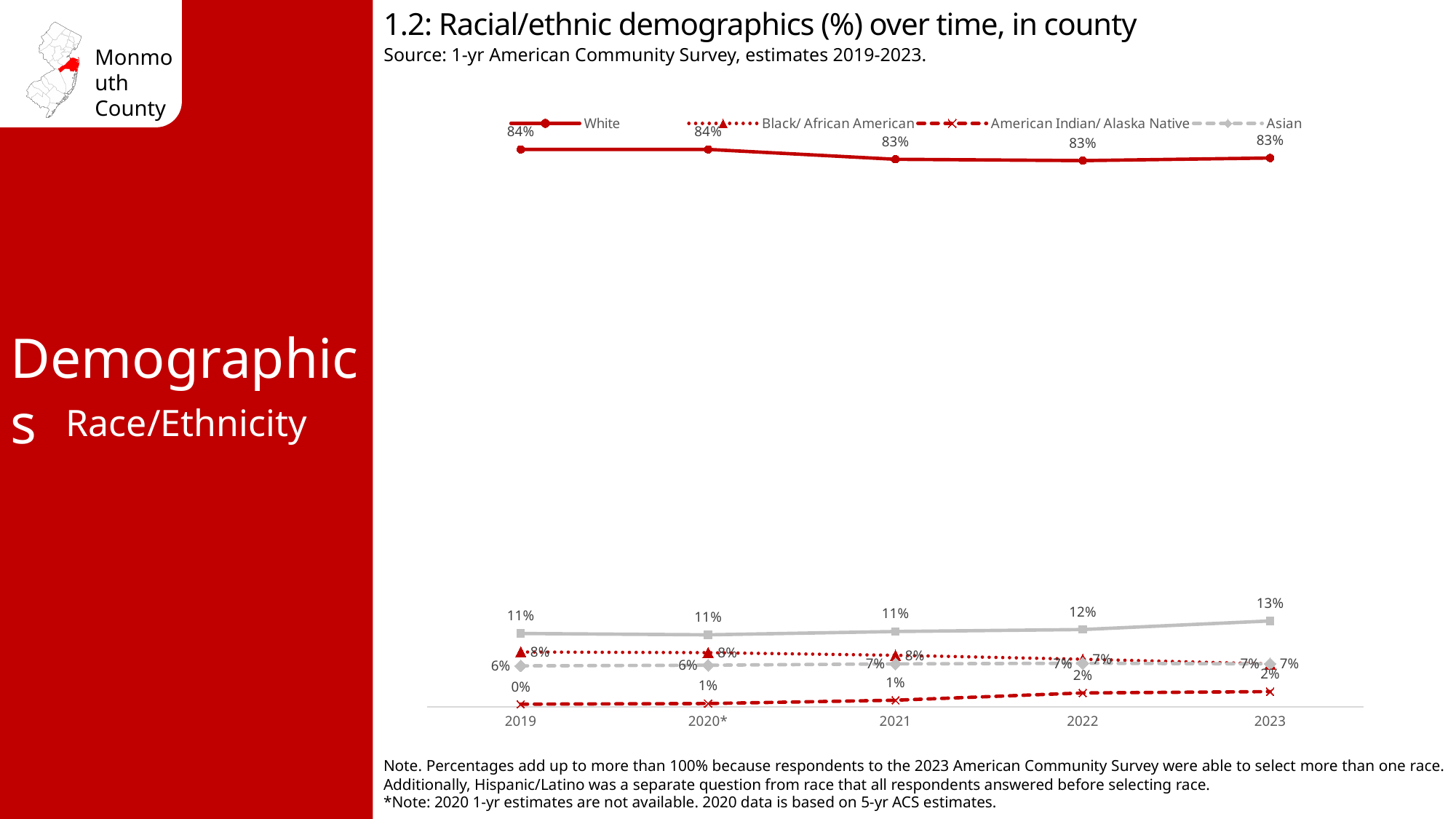
What percentage is shown for Asian in 2019? 6% Does the American Indian/ Alaska Native line rise or fall from 2019 to 2023? rise In 2019, which is larger: the Black/ African American value or the Asian value? Black/ African American What percentage is shown for White in 2023? 83% Which year on the x axis is marked with an asterisk? 2020* In which year is the American Indian/ Alaska Native value lowest? 2019 What kind of chart is shown on the slide? line chart How many years are shown on the x axis? 5 What percentage is shown for White in 2019? 84% What percentage is shown for American Indian/ Alaska Native in 2023? 2% What percentage is shown for Black/ African American in 2021? 8% By how many percentage points did the White share change from 2019 to 2023? 1 percentage point